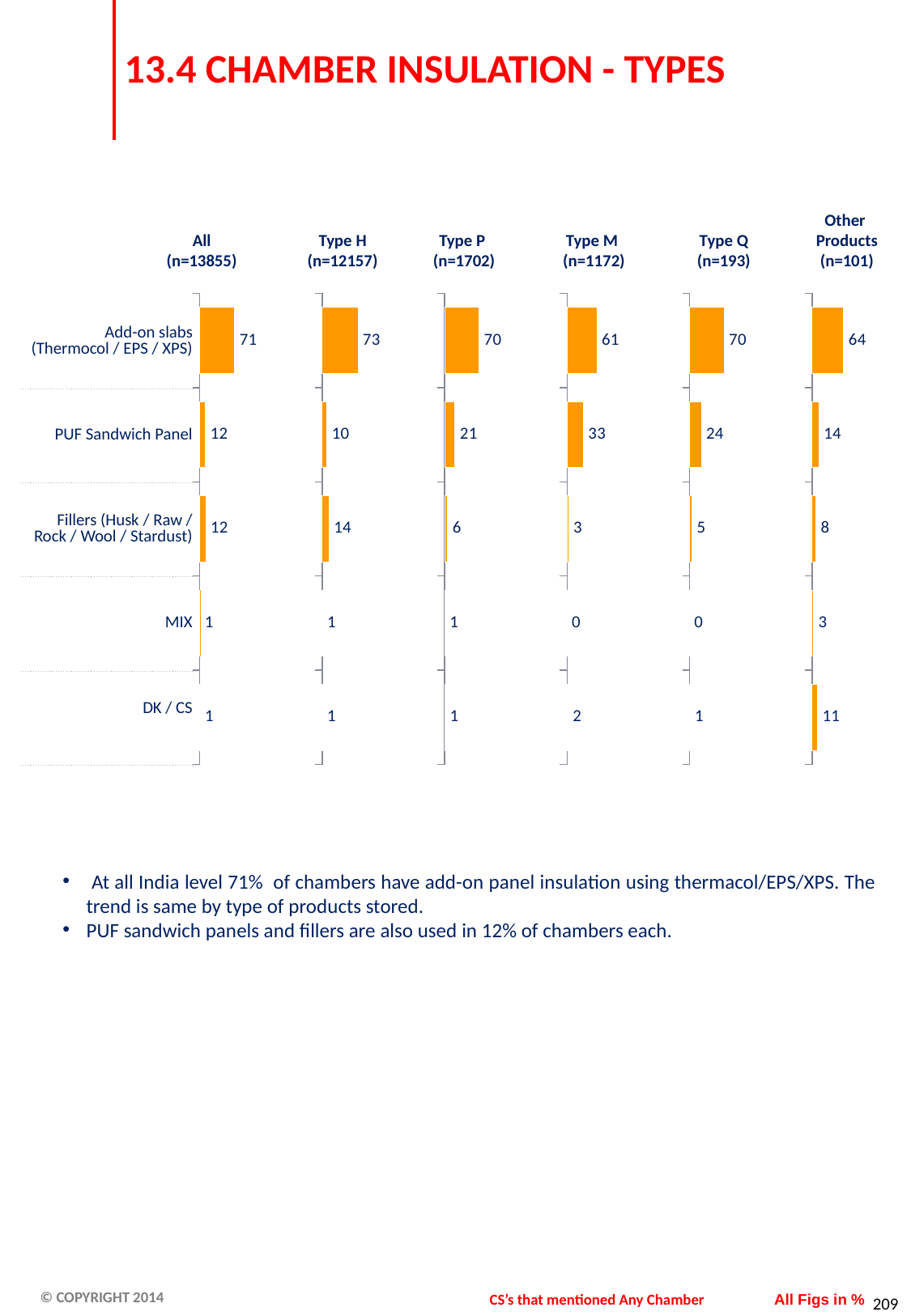
In the 'Type P (n=1702)' chart, what is the difference between the values for Add-on slabs (Thermocol / EPS / XPS) and PUF Sandwich Panel? 49 In the 'Type M (n=1172)' chart, which is larger: the value for PUF Sandwich Panel or the value for Fillers (Husk / Raw / Rock / Wool / Stardust)? PUF Sandwich Panel Across the charts, is the Add-on slabs value for Type H larger or smaller than the Add-on slabs value for Type M? larger In the 'All (n=13855)' chart, what is the value for Add-on slabs (Thermocol / EPS / XPS)? 71 How many separate bar charts are shown on the slide? 6 In the 'Type Q (n=193)' chart, which category has the lowest value? MIX In the 'Other Products (n=101)' chart, what is the value for DK / CS? 11 What type of chart is used for the 'All (n=13855)' data? bar chart What is the sample size (n) shown for the 'Type Q' chart? 193 In the 'Type H (n=12157)' chart, which category has the highest value? Add-on slabs (Thermocol / EPS / XPS) In the 'Type M (n=1172)' chart, what is the value for PUF Sandwich Panel? 33 How many categories are shown in each of the bar charts on the slide? 5